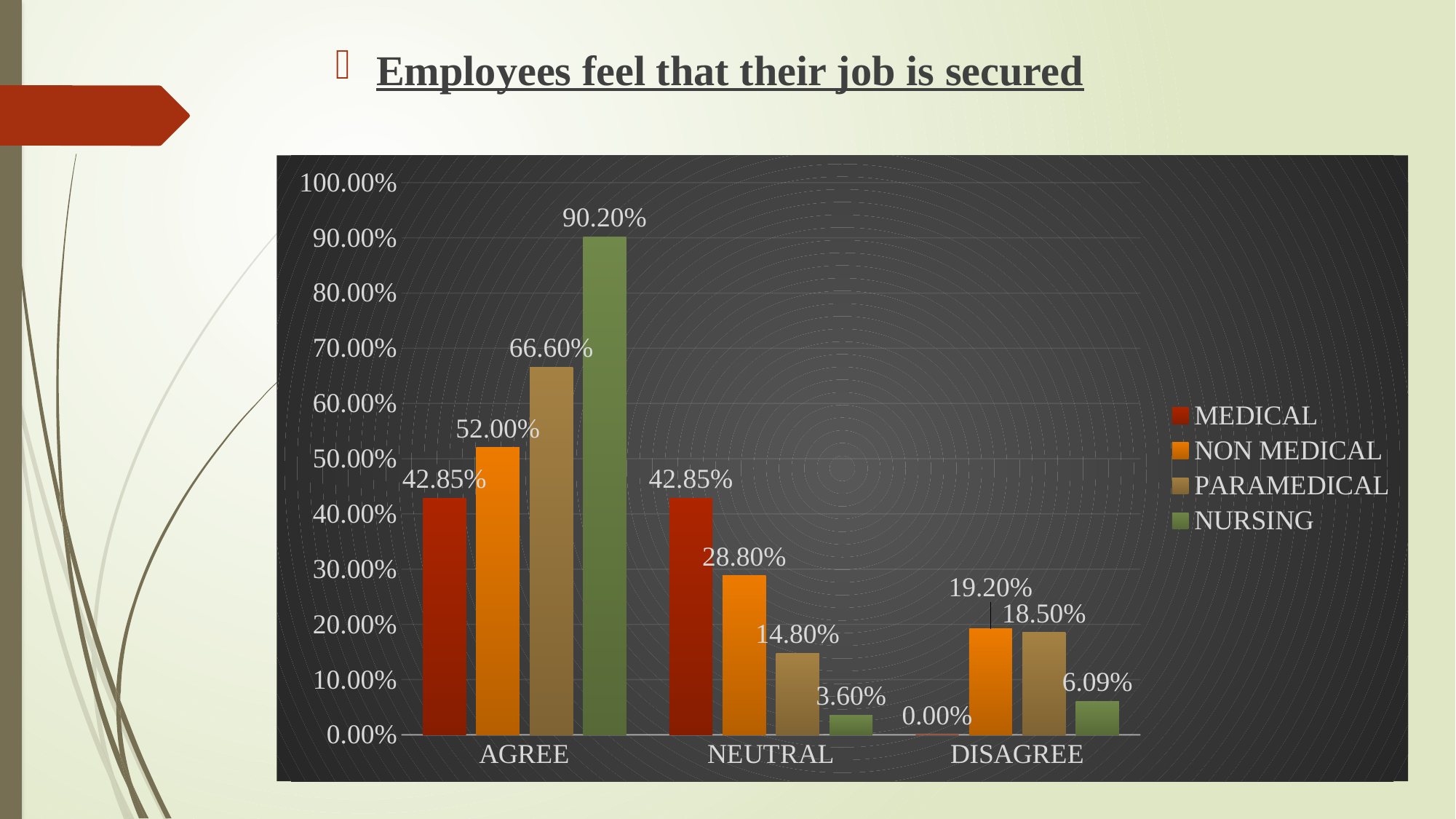
What is the value for NURSING in the AGREE category? 90.20% What is the title of the slide above the chart? Employees feel that their job is secured What is the difference between the NURSING and PARAMEDICAL values in the AGREE category? 23.60% How many categories are shown on the x axis? 3 How many series does the legend list? 4 Which series has the lowest value in the NEUTRAL category? NURSING What is the value for MEDICAL in the DISAGREE category? 0.00% What kind of chart is shown on the slide? bar chart What is the value for PARAMEDICAL in the NEUTRAL category? 14.80% Which series has the highest value in the AGREE category? NURSING In the DISAGREE category, which is larger: NON MEDICAL or NURSING? NON MEDICAL